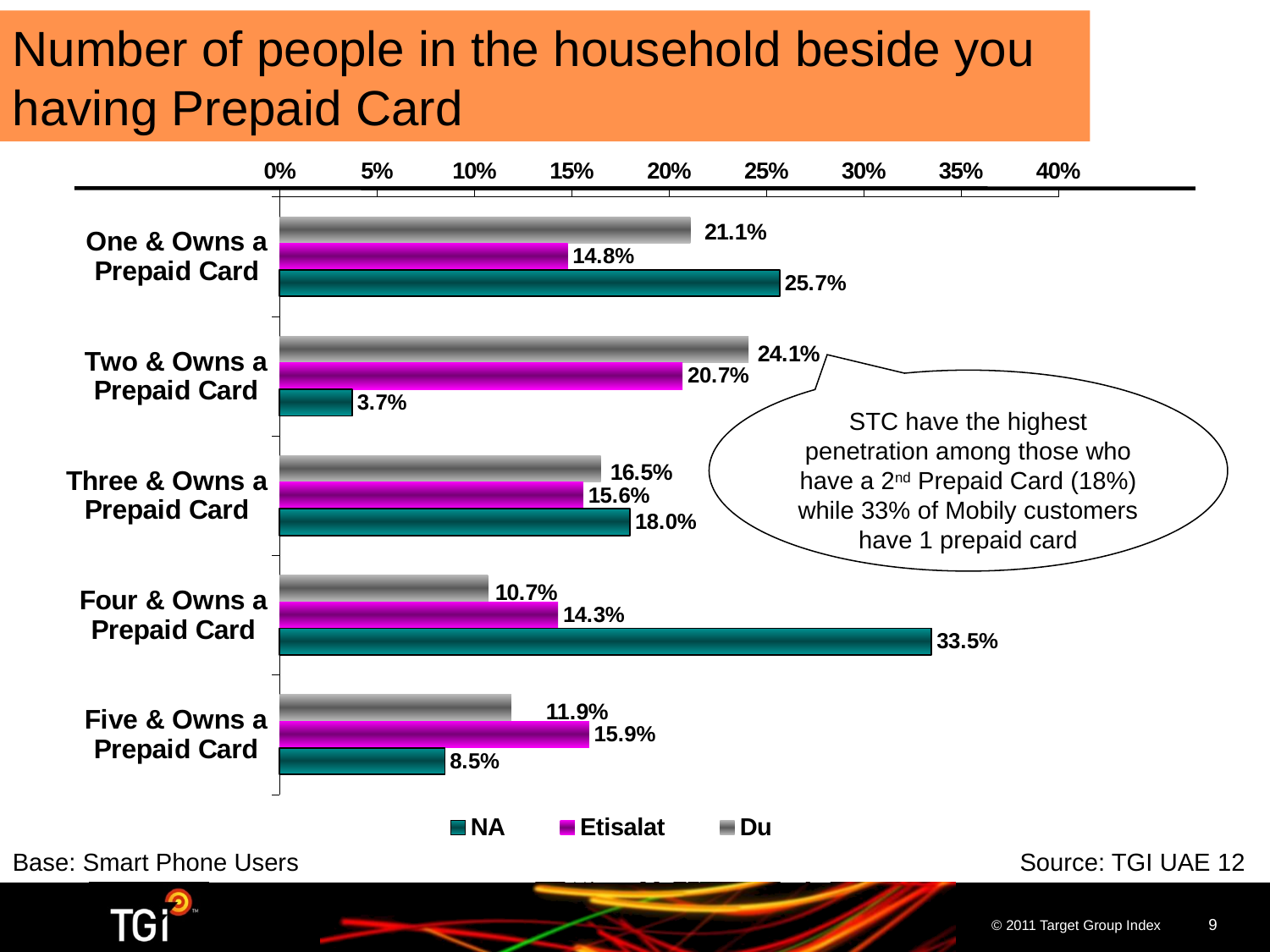
For "Three & Owns a Prepaid Card", which is larger: the NA value or the Du value? NA What is the Etisalat value for "Five & Owns a Prepaid Card"? 15.9% Which category has the lowest NA value? Two & Owns a Prepaid Card What kind of chart is shown on the slide? Bar chart What is the Du value for "Two & Owns a Prepaid Card"? 24.1% Which category has the highest NA value? Four & Owns a Prepaid Card Is the NA value for "Four & Owns a Prepaid Card" greater or less than 30%? greater Which category has the highest Du value? Two & Owns a Prepaid Card How many series does the legend list? 3 What is the difference between the NA and Etisalat values for "One & Owns a Prepaid Card"? 10.9% How many categories are shown on the chart? 5 What is the NA value for "Four & Owns a Prepaid Card"? 33.5%